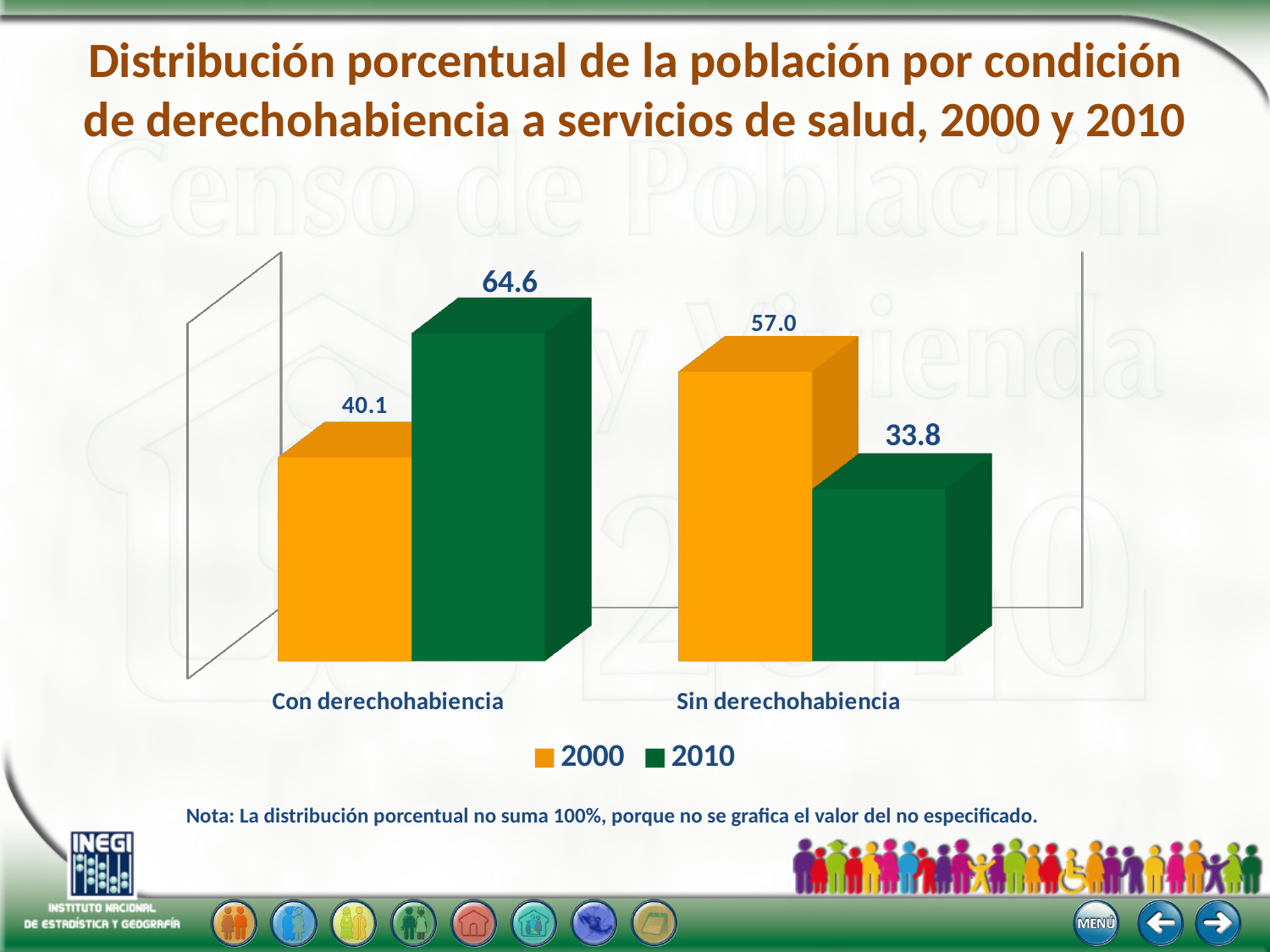
Which is larger: the 2000 value for Sin derechohabiencia or the 2010 value for Con derechohabiencia? 2010 value for Con derechohabiencia What is the value for Con derechohabiencia in 2010? 64.6 Which category has the lowest value in the 2000 series? Con derechohabiencia Which category has the highest value in the 2010 series? Con derechohabiencia What kind of chart is shown on the slide? Bar chart How many series does the legend list? 2 What is the value for Sin derechohabiencia in 2010? 33.8 What is the value for Sin derechohabiencia in 2000? 57.0 How many categories are shown on the x axis? 2 What is the difference between the 2000 and 2010 values for Sin derechohabiencia? 23.2 What is the difference between the 2010 and 2000 values for Con derechohabiencia? 24.5 What is the value for Con derechohabiencia in 2000? 40.1